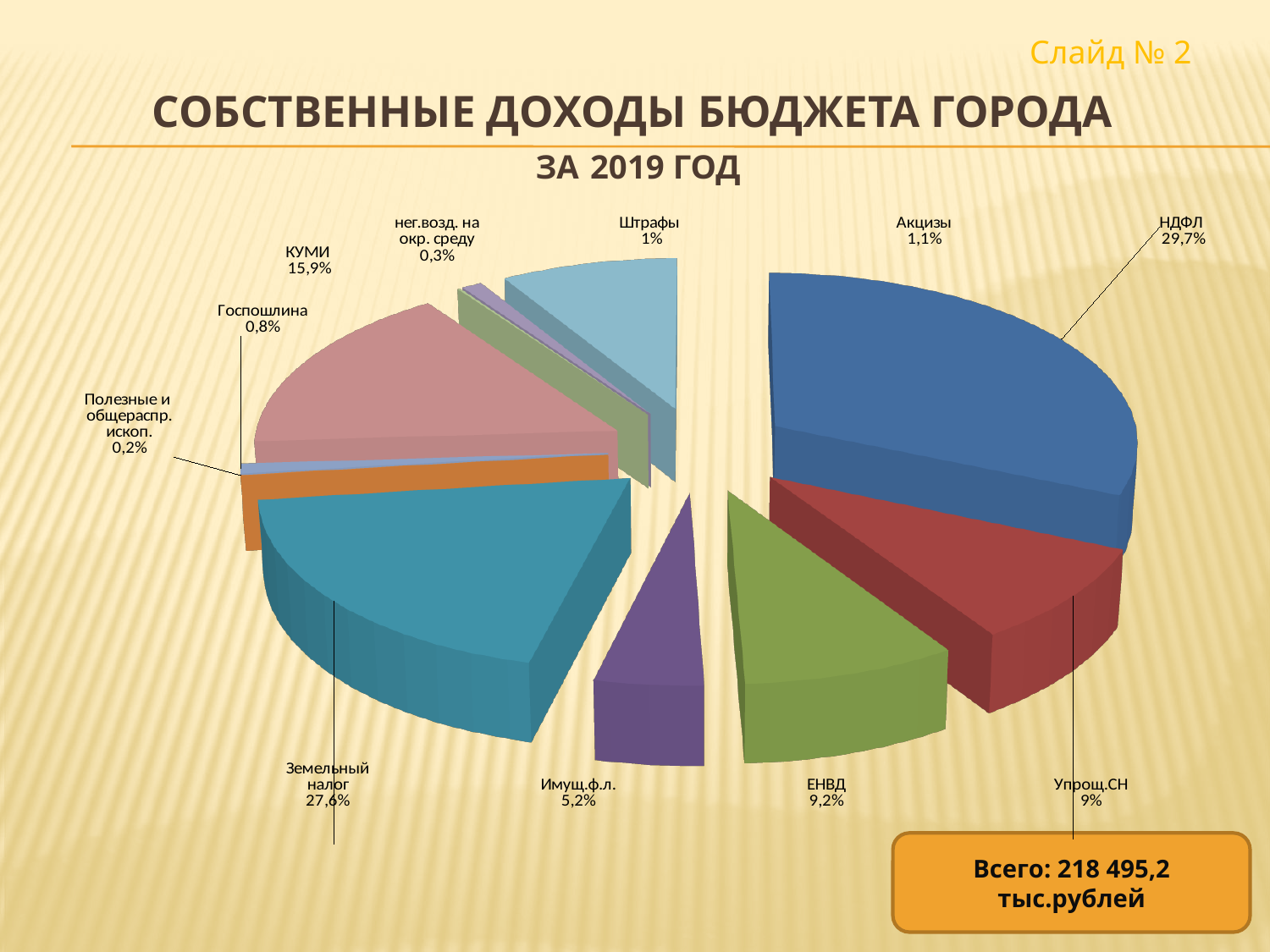
What is the combined share of Штрафы and Акцизы? 2,1% How many categories are shown in the pie chart? 11 Which category has the smallest share of the pie? Полезные и общераспр. ископ. Which is larger, the share of ЕНВД or the share of Упрощ.СН? ЕНВД What is the value shown for Земельный налог? 27,6% What is the value shown for ЕНВД? 9,2% What total amount is stated in the box below the chart? 218 495,2 тыс.рублей What share of the pie does НДФЛ account for? 29,7% What kind of chart is shown on the slide? Pie chart What is the difference between the shares of НДФЛ and Земельный налог? 2,1% Which category has the largest share of the pie? НДФЛ What percentage is shown for КУМИ? 15,9%